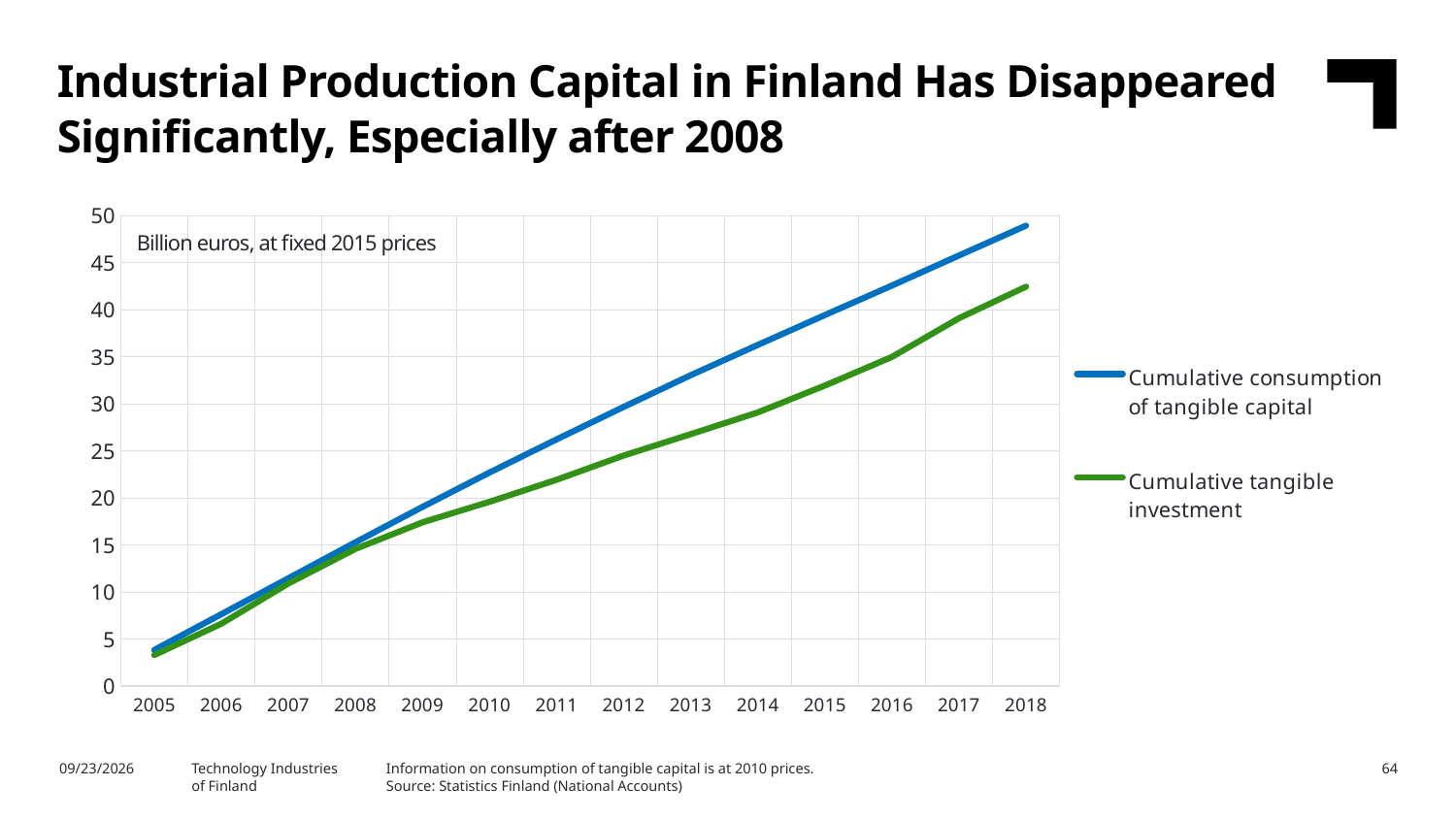
How many years are shown on the x axis? 14 What colour is the line for Cumulative tangible investment? green What unit is stated in the label inside the chart area? Billion euros, at fixed 2015 prices Is the value for Cumulative tangible investment in 2014 greater or less than 30? less Is the value for Cumulative consumption of tangible capital in 2005 greater or less than 5? less How many series does the legend list? 2 What type of chart is shown on the slide? line chart Is the value for Cumulative consumption of tangible capital in 2018 greater or less than 45? greater Do the values for Cumulative consumption of tangible capital rise or fall from 2005 to 2018? rise Do the values for Cumulative tangible investment rise or fall from 2005 to 2018? rise In 2018, which series has the larger value: Cumulative consumption of tangible capital or Cumulative tangible investment? Cumulative consumption of tangible capital